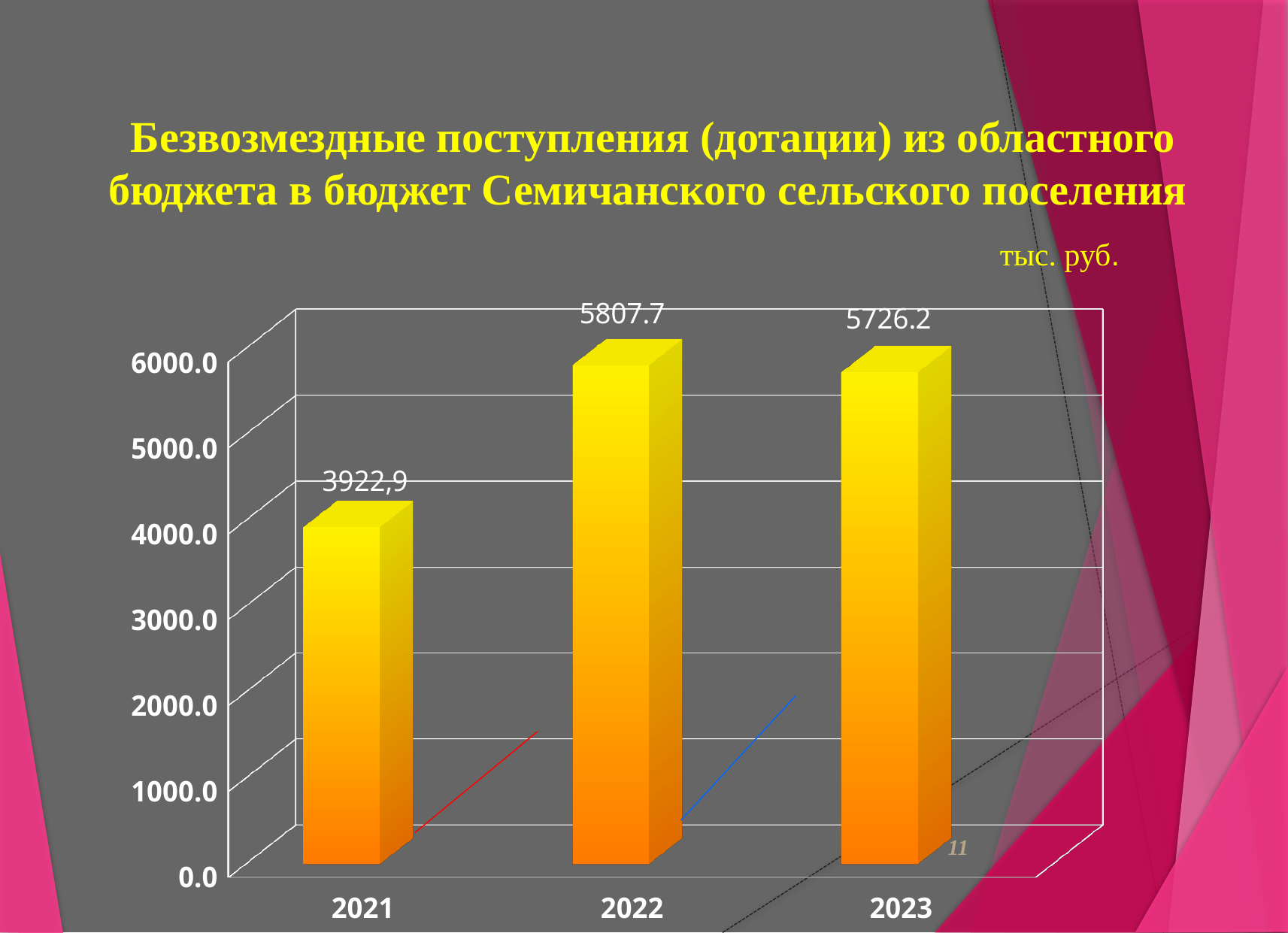
What unit of measurement is indicated for the chart? тыс. руб. Which year has the lowest value? 2021 What is the value for 2021? 3922,9 Which year has the highest value? 2022 What is the value for 2023? 5726.2 What is the difference between the values for 2022 and 2021? 1884.8 What is the value for 2022? 5807.7 Is the value for 2021 greater or less than 4000.0? less What kind of chart is shown on the slide? bar chart Which is larger, the value for 2022 or the value for 2023? 2022 What is the difference between the values for 2022 and 2023? 81.5 How many years are shown on the chart? 3